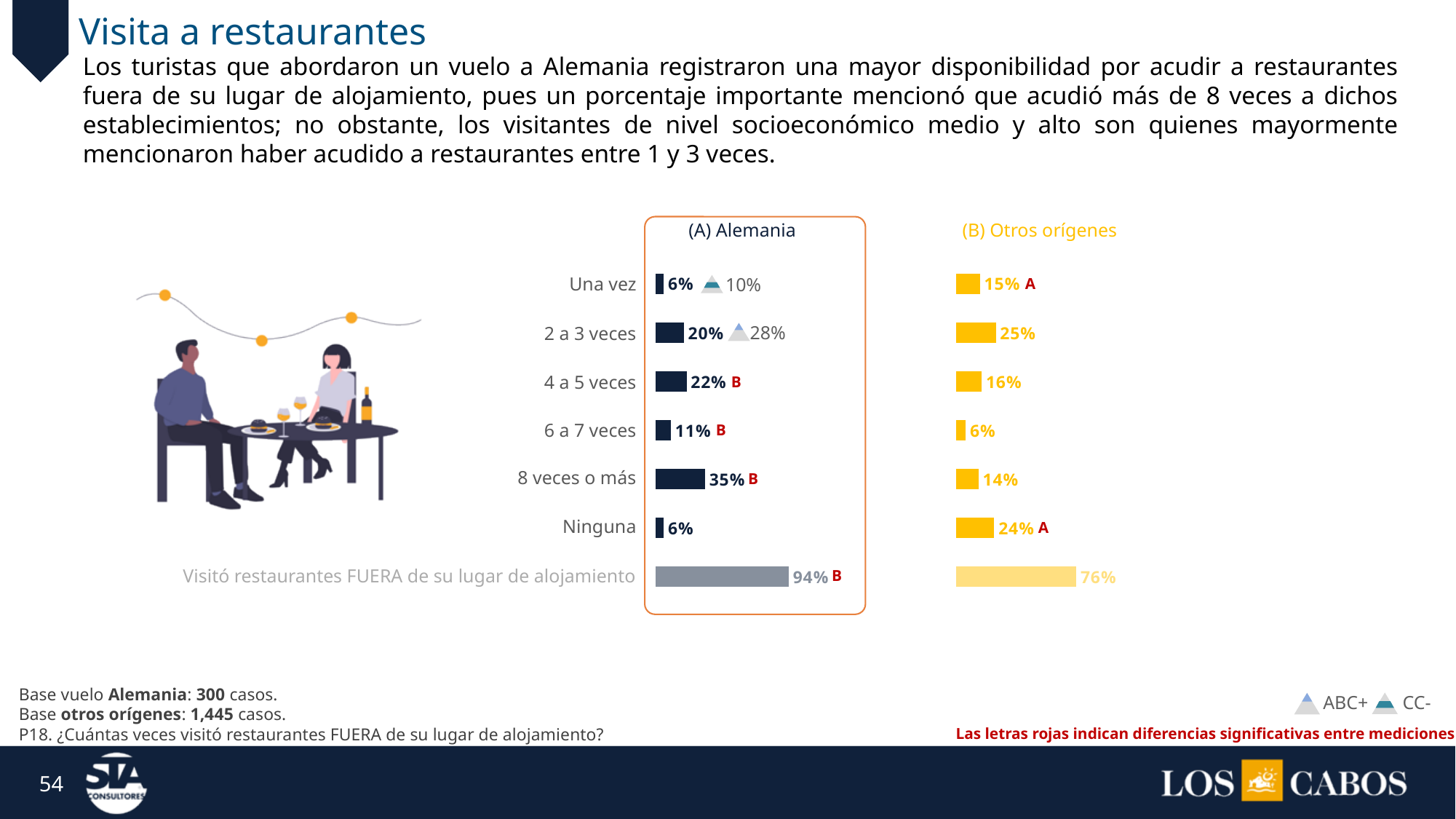
In the (B) Otros orígenes chart, what is the value for "Ninguna"? 24% In the (B) Otros orígenes chart, what is the value for "2 a 3 veces"? 25% What colour are the bars in the (B) Otros orígenes chart? Yellow In the (A) Alemania chart, which frequency category (excluding the summary bar) has the highest value? 8 veces o más In the (A) Alemania chart, what is the value for "Visitó restaurantes FUERA de su lugar de alojamiento"? 94% In the (A) Alemania chart, what is the value for "8 veces o más"? 35% For "Ninguna", which chart shows the larger value, (A) Alemania or (B) Otros orígenes? (B) Otros orígenes What is the difference between the "Visitó restaurantes FUERA de su lugar de alojamiento" values in the (A) Alemania chart and the (B) Otros orígenes chart? 18% What is the difference between the "8 veces o más" values in the (A) Alemania chart and the (B) Otros orígenes chart? 21% In the (B) Otros orígenes chart, which category has the lowest value? 6 a 7 veces What type of chart is used for (B) Otros orígenes? Bar chart How many frequency categories are listed in the (A) Alemania chart, excluding the summary bar "Visitó restaurantes FUERA de su lugar de alojamiento"? 6